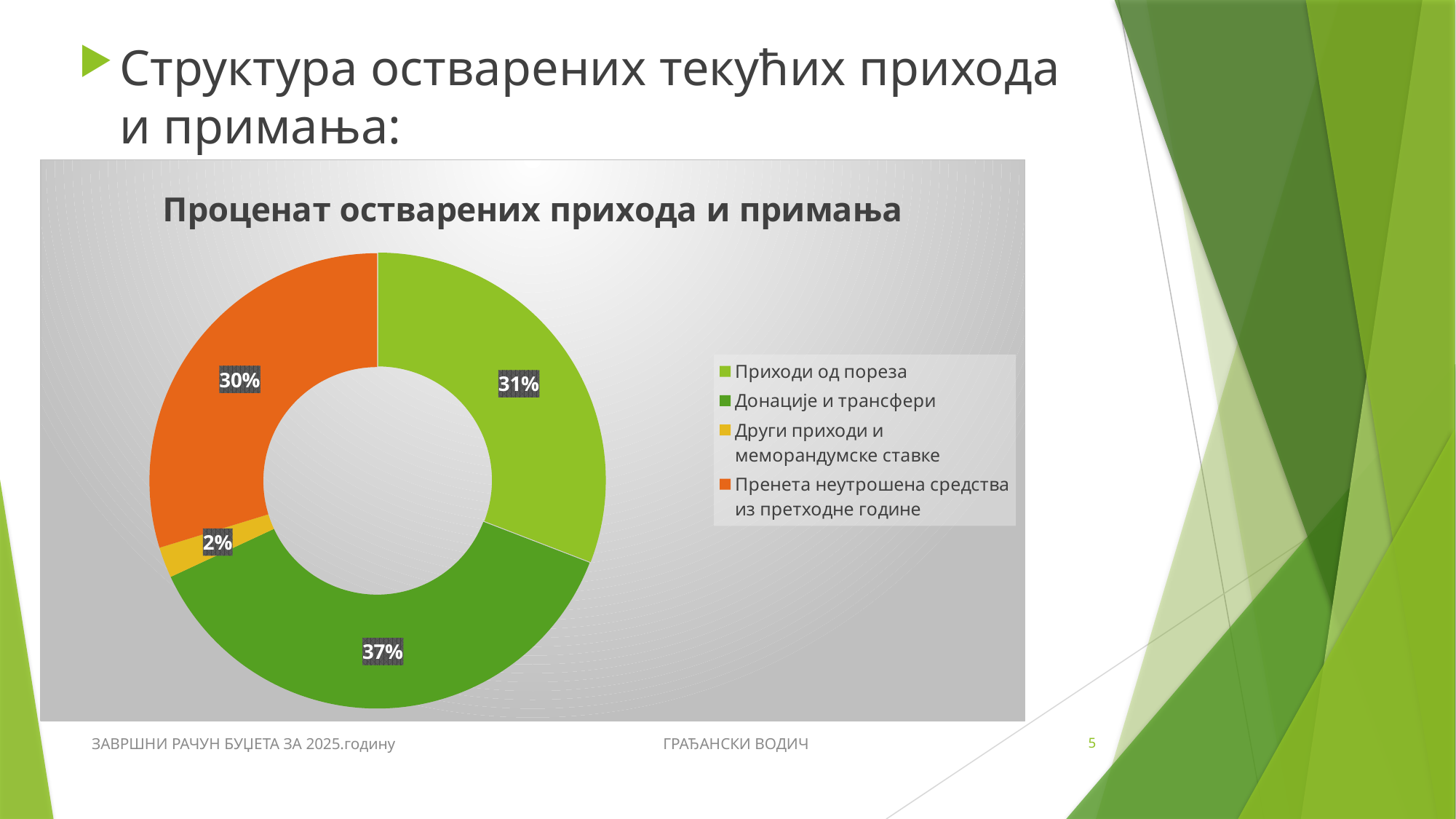
What share does Други приходи и меморандумске ставке have in the chart? 2% What kind of chart is shown on the slide? Doughnut (pie) chart How many categories are shown in the chart? 4 Which category has the largest share in the chart? Донације и трансфери What share does Приходи од пореза have in the chart? 31% Which category has the smallest share in the chart? Други приходи и меморандумске ставке What colour is the slice for Пренета неутрошена средства из претходне године? Orange Which is larger: the share of Приходи од пореза or the share of Пренета неутрошена средства из претходне године? Приходи од пореза What share does Донације и трансфери have in the chart? 37% What is the title of the chart? Проценат остварених прихода и примања What share does Пренета неутрошена средства из претходне године have in the chart? 30% What is the difference in percentage points between Донације и трансфери and Приходи од пореза? 6